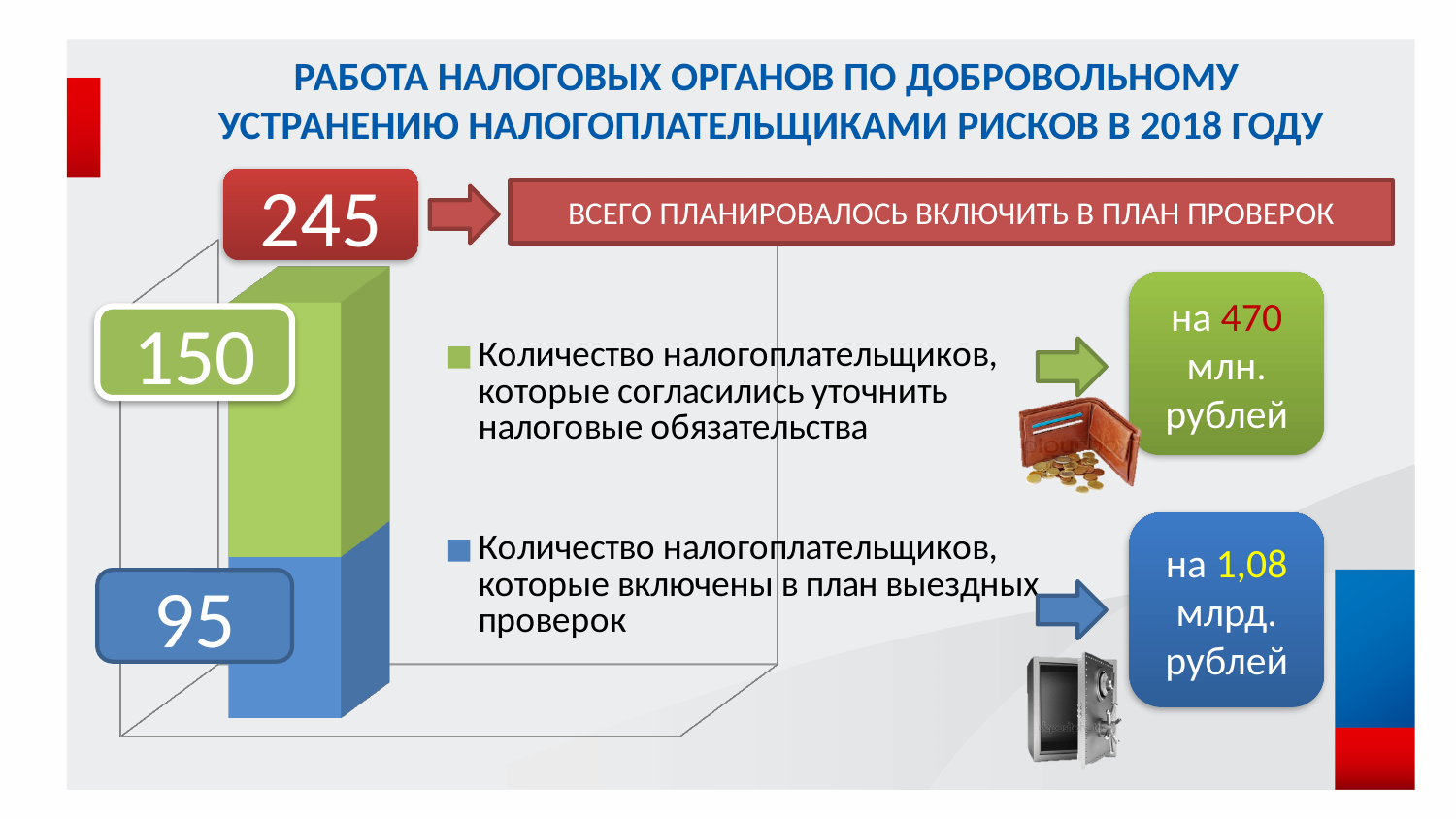
Каким цветом обозначены налогоплательщики, которые согласились уточнить налоговые обязательства? Зелёным Какого типа эта диаграмма? Столбчатая диаграмма с накоплением Чему равна сумма сегментов столбца (всего планировалось включить в план проверок)? 245 Какой сегмент столбца больше: налогоплательщики, согласившиеся уточнить обязательства, или включённые в план выездных проверок? Согласившиеся уточнить налоговые обязательства Каким цветом обозначены налогоплательщики, которые включены в план выездных проверок? Синим Какой сегмент столбца имеет наибольшее значение? Количество налогоплательщиков, которые согласились уточнить налоговые обязательства Сколько рядов данных перечислено в легенде диаграммы? 2 На сколько количество налогоплательщиков, согласившихся уточнить обязательства, больше количества включённых в план выездных проверок? 55 Какое значение показано для количества налогоплательщиков, которые включены в план выездных проверок? 95 Какое значение показано для количества налогоплательщиков, которые согласились уточнить налоговые обязательства? 150 Какой сегмент столбца имеет наименьшее значение? Количество налогоплательщиков, которые включены в план выездных проверок